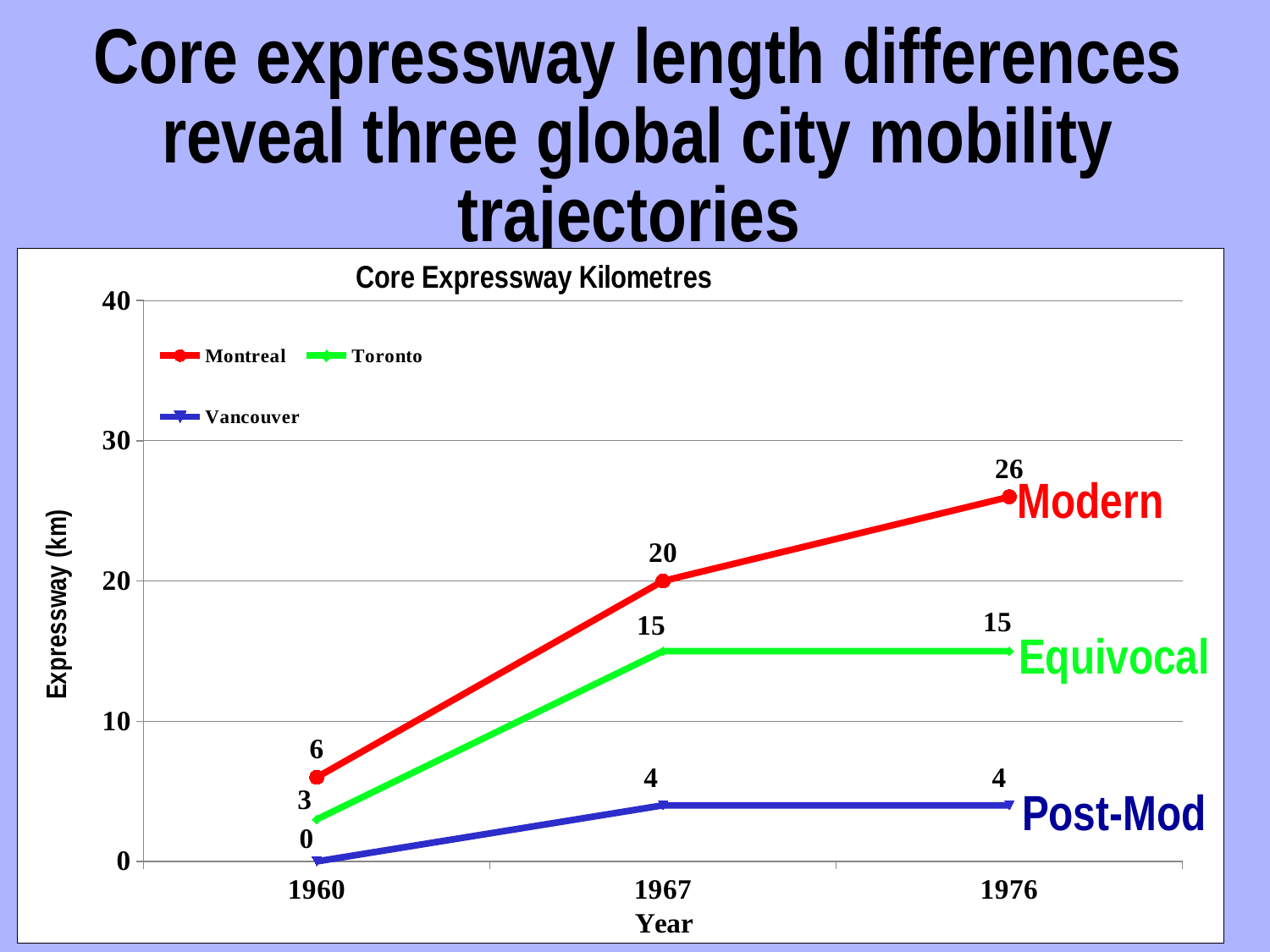
What is the value for Vancouver in 1960? 0 Which city has the highest value in 1976? Montreal Which city has the lowest value in 1967? Vancouver How many series does the legend list? 3 What is the value for Toronto in 1967? 15 Which is larger, Montreal in 1960 or Toronto in 1960? Montreal in 1960 How many years are shown on the x axis? 3 What is the title of the chart? Core Expressway Kilometres What kind of chart is shown? Line chart What is the difference between Montreal and Toronto in 1976? 11 Does the value for Montreal rise or fall from 1960 to 1976? Rise What is the value for Montreal in 1976? 26